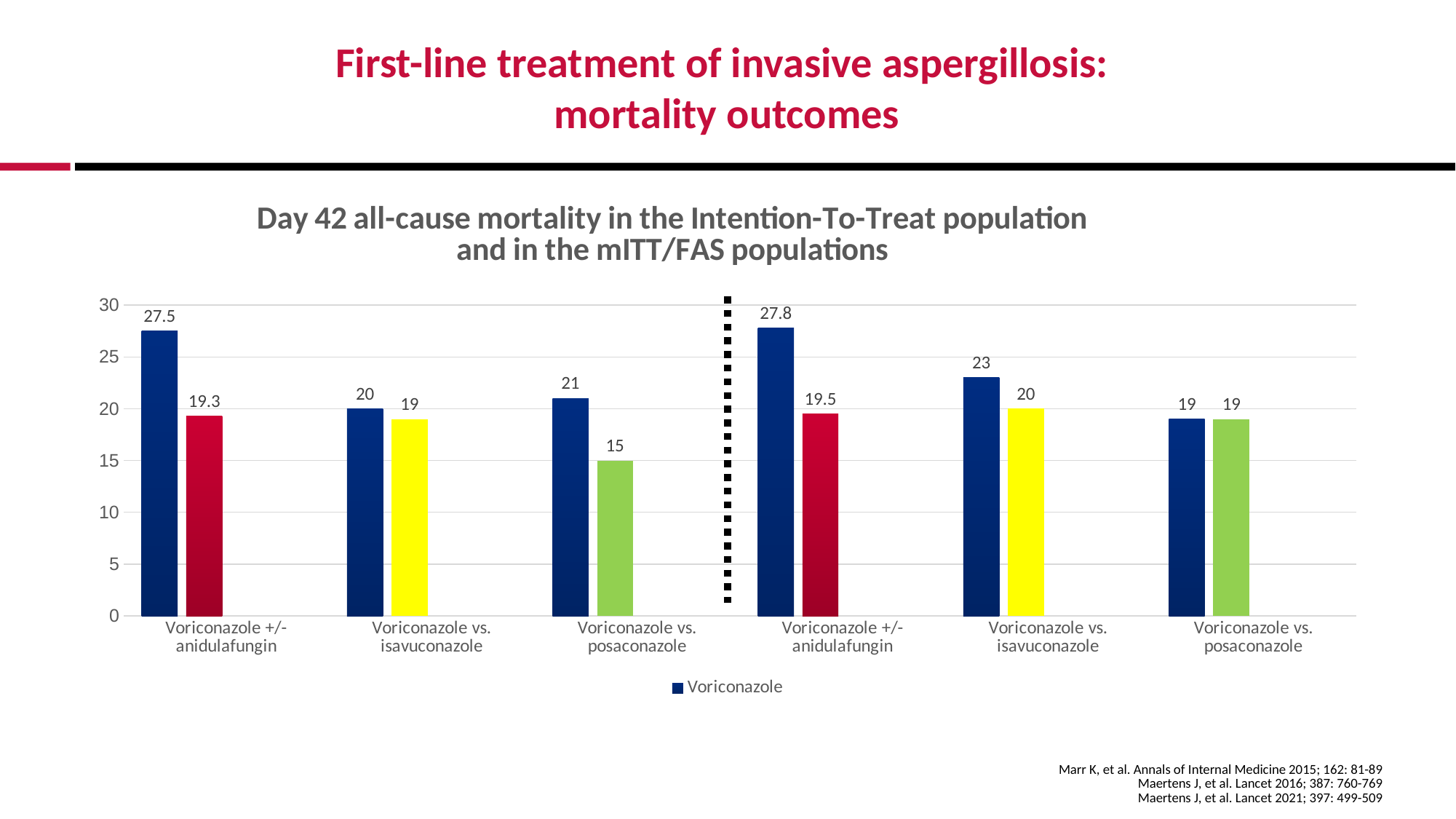
What is the value of the blue Voriconazole bar for 'Voriconazole +/- anidulafungin' in the group to the left of the dotted line? 27.5 What type of chart is shown on the slide? bar chart What is the difference between the blue Voriconazole bar and the green bar for 'Voriconazole vs. posaconazole' to the left of the dotted line? 6 Which bar has the highest value on the whole chart? Voriconazole in 'Voriconazole +/- anidulafungin' to the right of the dotted line (27.8) How many category groups are shown along the x axis of the chart? 6 What is the difference between the blue Voriconazole bar and the red bar for 'Voriconazole +/- anidulafungin' to the left of the dotted line? 8.2 What is the value of the red comparator bar for 'Voriconazole +/- anidulafungin' in the group to the right of the dotted line? 19.5 What is the value of the blue Voriconazole bar for 'Voriconazole vs. isavuconazole' in the group to the right of the dotted line? 23 Which bar has the lowest value on the whole chart? the green bar for 'Voriconazole vs. posaconazole' to the left of the dotted line (15) Which series is listed in the chart legend? Voriconazole What is the value of the green bar for 'Voriconazole vs. posaconazole' in the group to the left of the dotted line? 15 For 'Voriconazole vs. isavuconazole' to the right of the dotted line, which is larger: the blue Voriconazole bar or the yellow bar? the blue Voriconazole bar